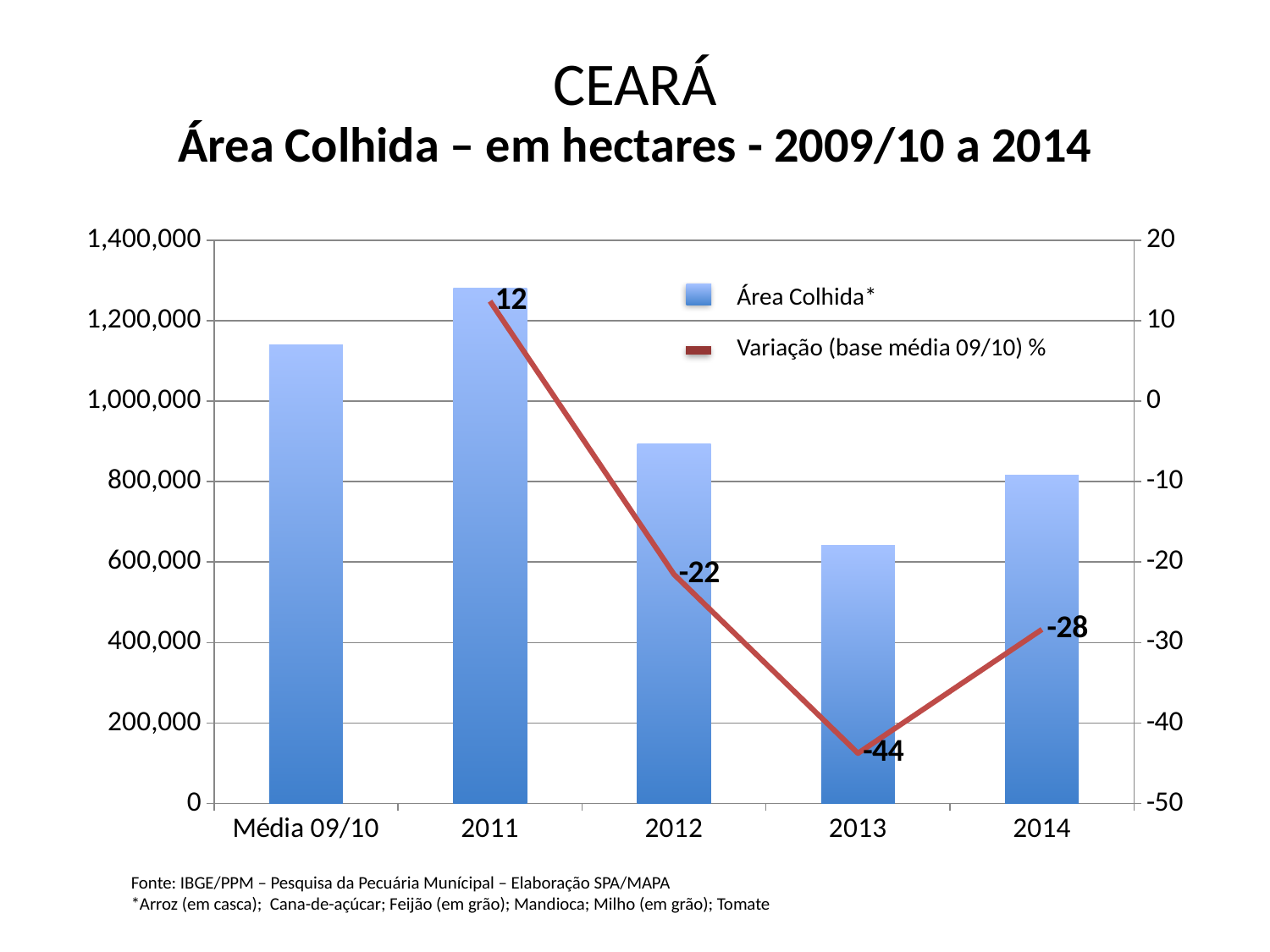
What is the value of Variação (base média 09/10) % for 2013? -44 What is the difference between the Variação values for 2011 and 2013? 56 Which has a larger Área Colhida* bar, 2012 or 2014? 2012 How many series does the legend list? 2 Is the Área Colhida* value for 2013 greater or less than 800,000? less Does the Variação (base média 09/10) % line rise or fall from 2011 to 2013? fall How many categories are shown on the x axis? 5 Which category has the shortest Área Colhida* bar? 2013 What is the value of Variação (base média 09/10) % for 2014? -28 Which category has the tallest Área Colhida* bar? 2011 Is the Área Colhida* value for Média 09/10 greater or less than 1,000,000? greater What is the value of Variação (base média 09/10) % for 2011? 12